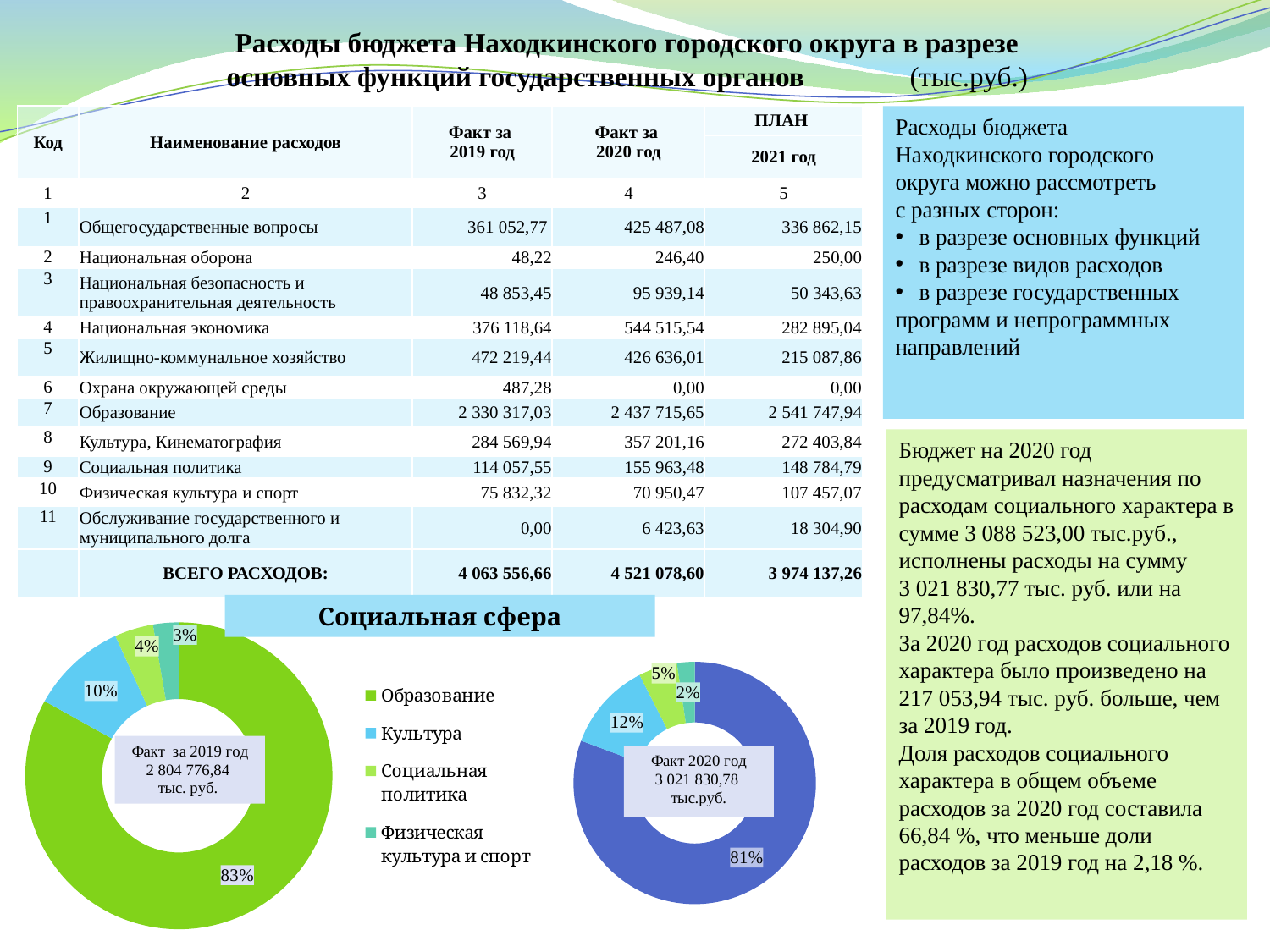
What total amount is printed in the centre of the left doughnut chart (Факт за 2019 год)? 2 804 776,84 тыс. руб. How many categories does the legend of the 'Социальная сфера' charts list? 4 In the left doughnut chart (Факт за 2019 год), what share does the largest slice have? 83% In the right doughnut chart (Факт 2020 год), what share does the largest slice have? 81% In the left doughnut chart (Факт за 2019 год), which category has the largest share? Образование What kind of chart is used for the 'Социальная сфера' section of the slide? Doughnut (pie) chart In the right doughnut chart (Факт 2020 год), what is the smallest slice's share? 2% In the left doughnut chart (Факт за 2019 год), what is the difference between the 83% slice and the 10% slice? 73% In the left doughnut chart (Факт за 2019 год), what is the smallest slice's share? 3% What total amount is printed in the centre of the right doughnut chart (Факт 2020 год)? 3 021 830,78 тыс.руб. Which is larger: the 10% slice in the 2019 chart or the 12% slice in the 2020 chart? The 12% slice in the 2020 chart How many charts are shown under the heading 'Социальная сфера'? 2